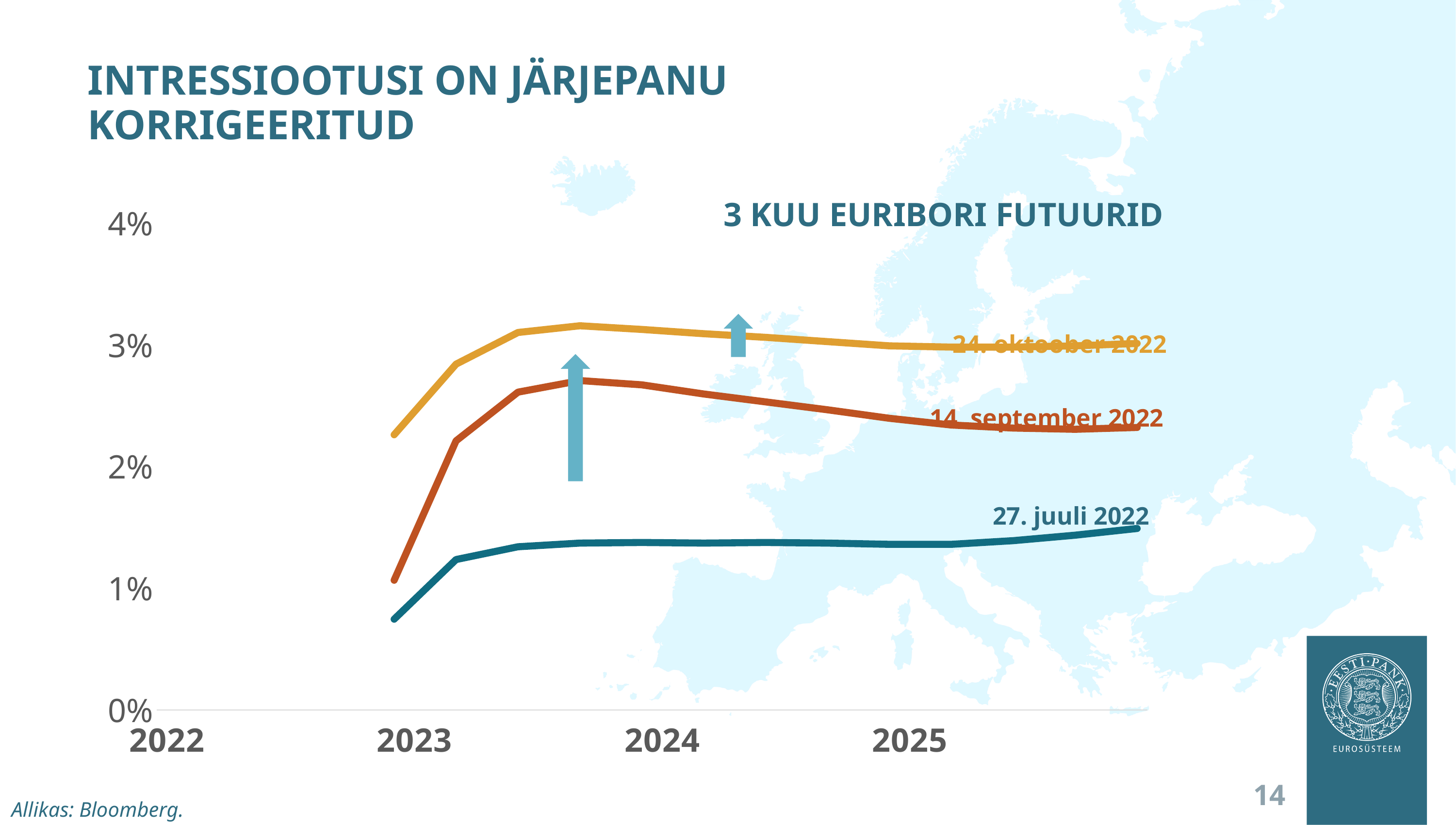
Which series lies lowest on the chart across the whole period? 27. juuli 2022 At 2024, which line is higher: 14. september 2022 or 27. juuli 2022? 14. september 2022 Is the starting value of the 27. juuli 2022 line at 2023 greater or less than 1%? less How many series (dated lines) does the chart show? 3 What is the title of the chart? 3 KUU EURIBORI FUTUURID Which series lies highest on the chart across the whole period? 24. oktoober 2022 Is the value of the 27. juuli 2022 line at 2024 greater or less than 2%? less What kind of chart is shown on the slide? line chart Is the value of the 14. september 2022 line at 2025 greater or less than 3%? less What source is cited for the chart? Bloomberg After reaching its peak in late 2023, does the 14. september 2022 line rise or fall toward 2025? fall